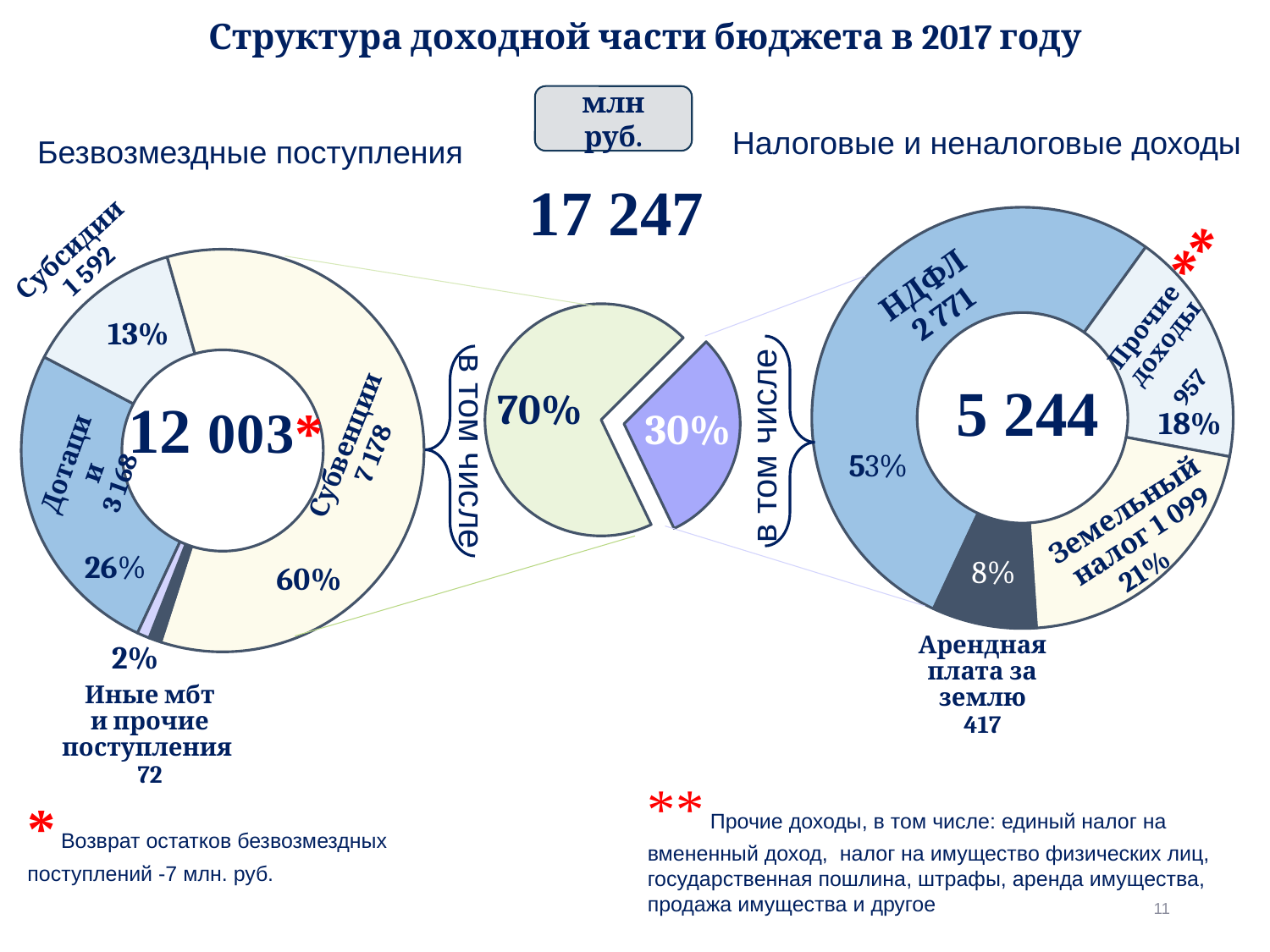
In the left donut chart 'Безвозмездные поступления', what is the value for Субвенции? 7 178 In the right donut chart 'Налоговые и неналоговые доходы', which is larger: Прочие доходы or Земельный налог? Земельный налог In the left donut chart 'Безвозмездные поступления', what is the difference between the values for Субвенции and Дотации? 4 010 In the right donut chart 'Налоговые и неналоговые доходы', what is the value for НДФЛ? 2 771 In the left donut chart 'Безвозмездные поступления', which category has the largest share? Субвенции In the left donut chart 'Безвозмездные поступления', which category has the smallest share? Иные мбт и прочие поступления In the left donut chart 'Безвозмездные поступления', what percentage share do Дотации have? 26% What is the total shown in the center of the right donut chart 'Налоговые и неналоговые доходы'? 5 244 In the right donut chart 'Налоговые и неналоговые доходы', which category has the smallest share? Арендная плата за землю In the right donut chart 'Налоговые и неналоговые доходы', what percentage share does Земельный налог have? 21% In the center pie chart, what share is shown for the larger slice? 70%